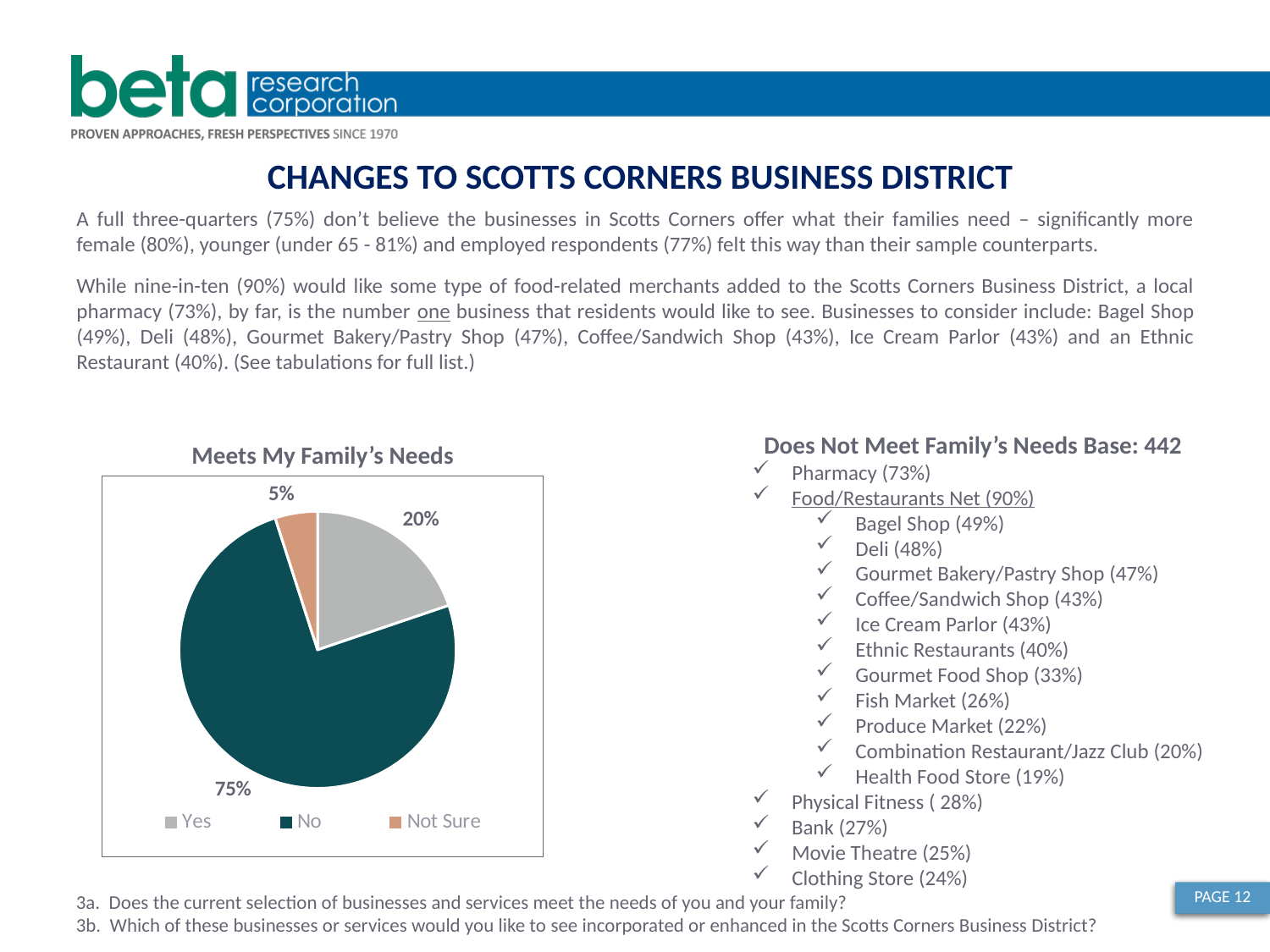
What is the title of the pie chart? Meets My Family's Needs What percentage of the pie chart is labelled "No"? 75% Which is larger in the pie chart, the "Yes" slice or the "Not Sure" slice? Yes What is the difference in percentage points between the "No" slice and the "Yes" slice? 55 Which slice of the pie chart is the largest? No How many entries does the pie chart's legend list? 3 How many slices does the pie chart have? 3 What percentage of the pie chart is labelled "Not Sure"? 5% Which slice of the pie chart is the smallest? Not Sure What percentage of the pie chart is labelled "Yes"? 20% What share of the pie does the "No" slice represent? 75% What kind of chart is shown on the slide? pie chart